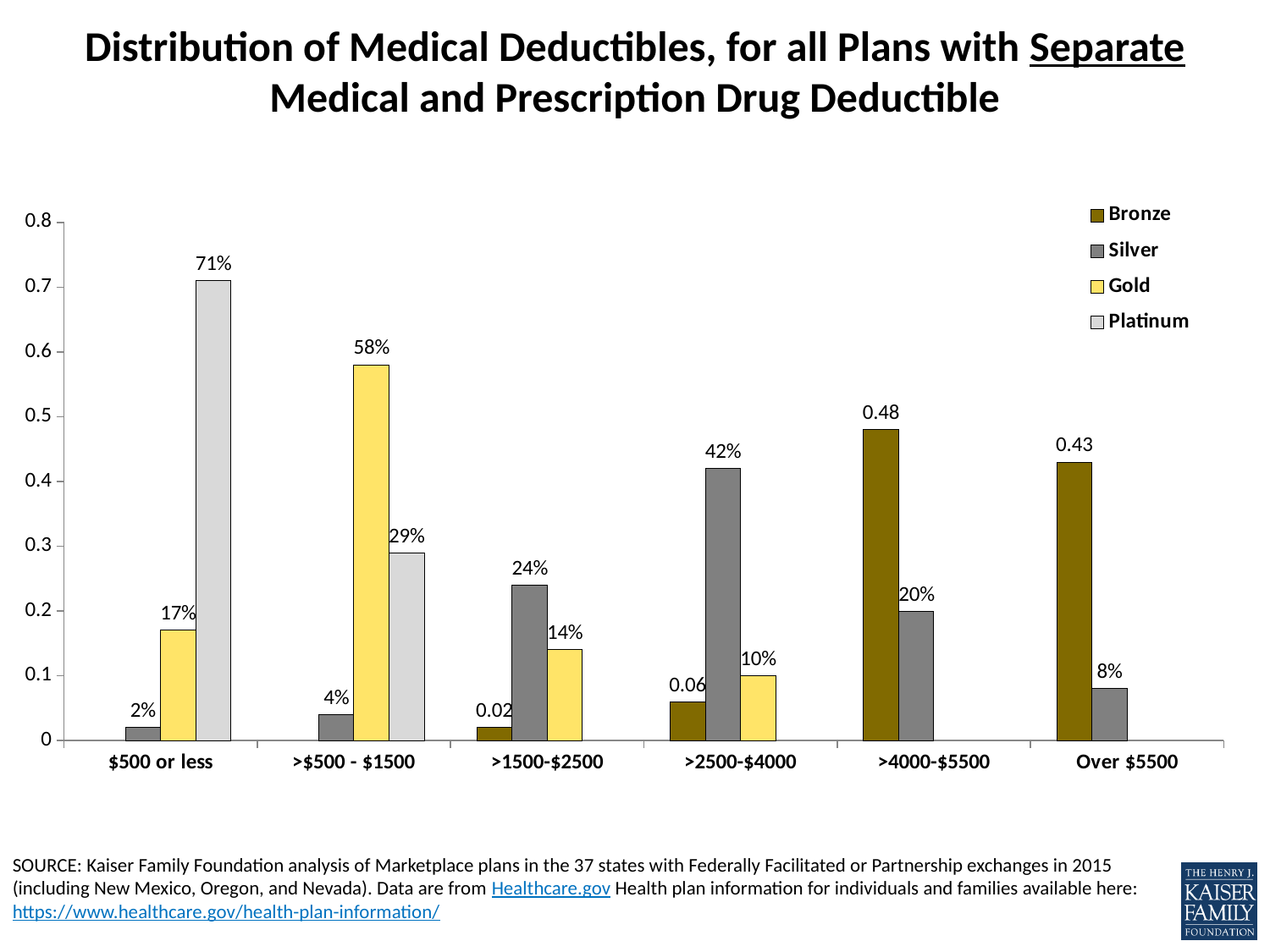
In which category is the Silver value lowest? $500 or less What is the value for Gold in the ">$500 - $1500" category? 58% What is the value for Platinum in the "$500 or less" category? 71% What is the value for Silver in the "Over $5500" category? 8% What is the value for Bronze in the ">4000-$5500" category? 0.48 In which category is the Silver value highest? >2500-$4000 What is the difference between the Gold and Platinum values in the ">$500 - $1500" category? 29% How many deductible categories are shown on the x axis? 6 Is the Bronze value larger in ">4000-$5500" or in "Over $5500"? >4000-$5500 How many series does the legend list? 4 What is the value for Silver in the ">2500-$4000" category? 42% Which series has the highest value in the "$500 or less" category? Platinum